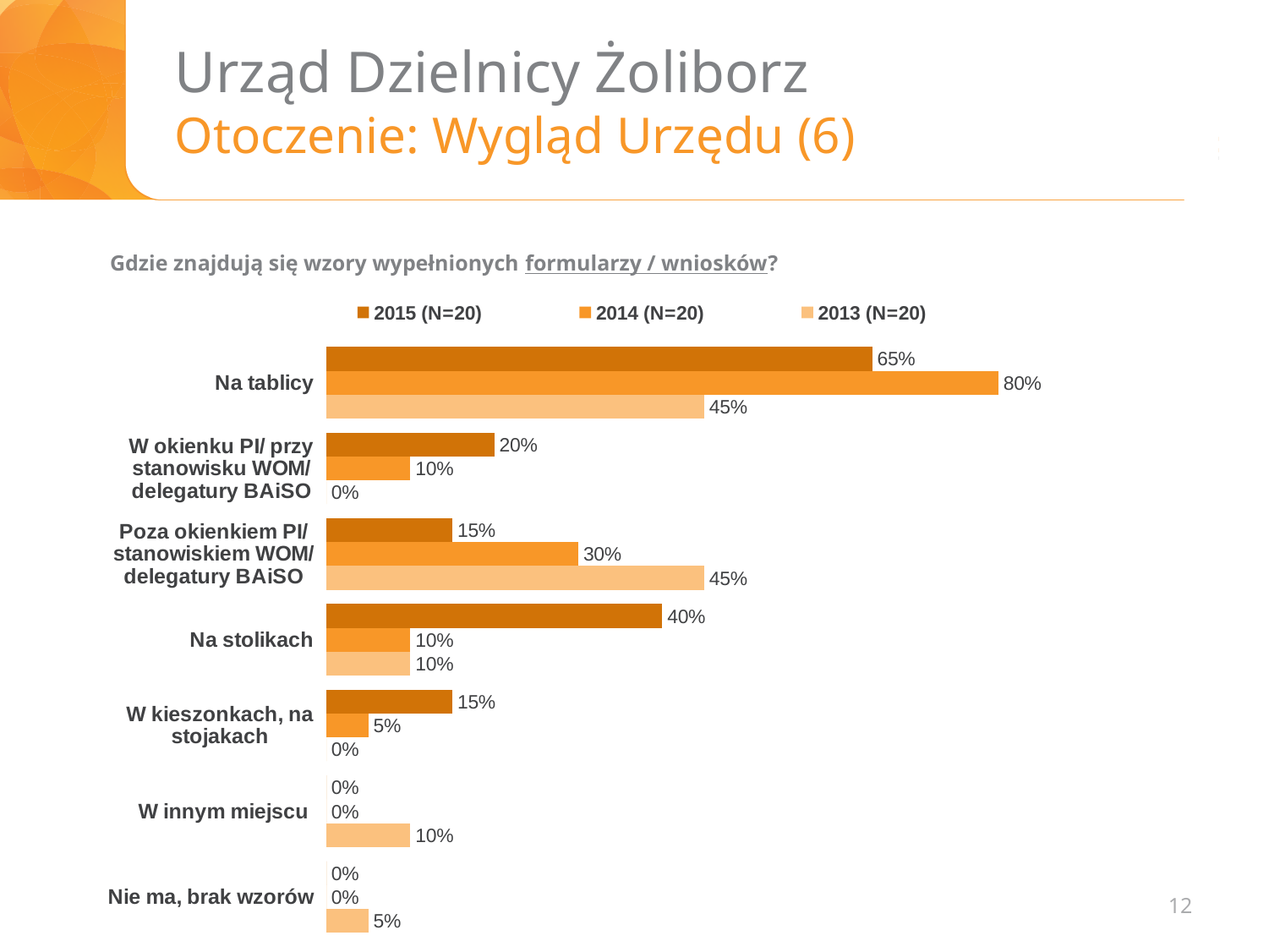
Which category has the highest value in the 2015 (N=20) series? Na tablicy What is the value for "Poza okienkiem PI/ stanowiskiem WOM/ delegatury BAiSO" in the 2013 (N=20) series? 45% What kind of chart is shown on the slide? Bar chart How many series does the legend list? 3 What is the value for "Na tablicy" in the 2014 (N=20) series? 80% What question does the chart answer, according to the text above it? Gdzie znajdują się wzory wypełnionych formularzy / wniosków? What is the value for "Nie ma, brak wzorów" in the 2013 (N=20) series? 5% Which is larger for "W okienku PI/ przy stanowisku WOM/ delegatury BAiSO": the 2015 (N=20) value or the 2014 (N=20) value? 2015 (N=20) How many categories are shown on the chart? 7 Which category has the highest value in the 2014 (N=20) series? Na tablicy What is the difference between the 2014 (N=20) and 2013 (N=20) values for "Na tablicy"? 35% What is the value for "Na stolikach" in the 2015 (N=20) series? 40%